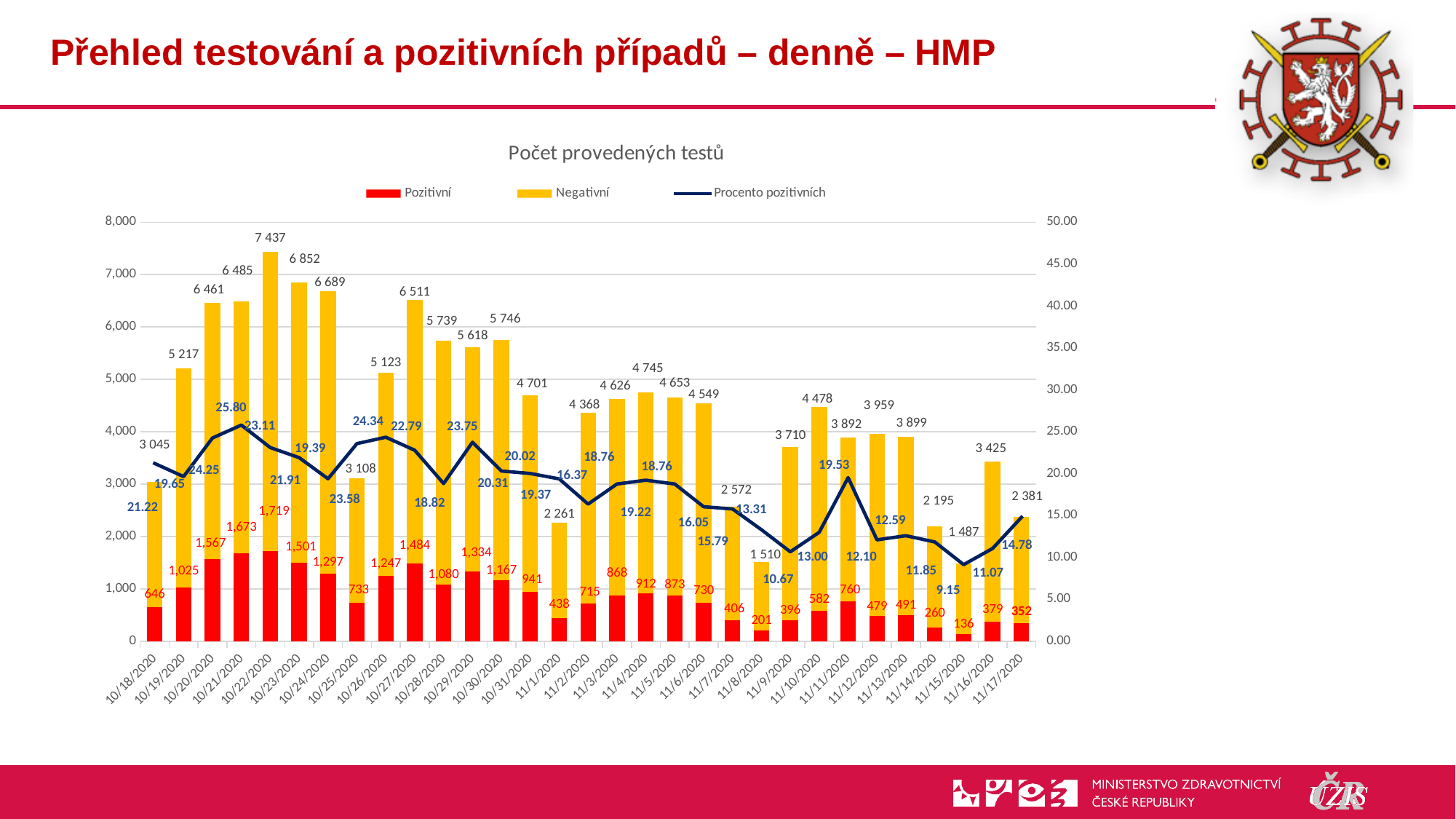
What is the Pozitivní value for 10/22/2020? 1,719 What is the title of the chart? Počet provedených testů Which date has the larger Pozitivní value, 11/3/2020 or 11/4/2020? 11/4/2020 What is the difference between the Pozitivní values for 10/19/2020 and 10/18/2020? 379 Which date has the lowest Pozitivní value? 11/15/2020 What kind of chart is shown on the slide? bar chart (stacked bars with a line) What is the Procento pozitivních value for 10/21/2020? 25.80 Which date has the highest total number of tests? 10/22/2020 What is the total number of tests labelled above the bar for 10/22/2020? 7 437 How many series does the legend list? 3 Which date has the lowest Procento pozitivních value? 11/15/2020 How many dates are shown on the x axis? 31